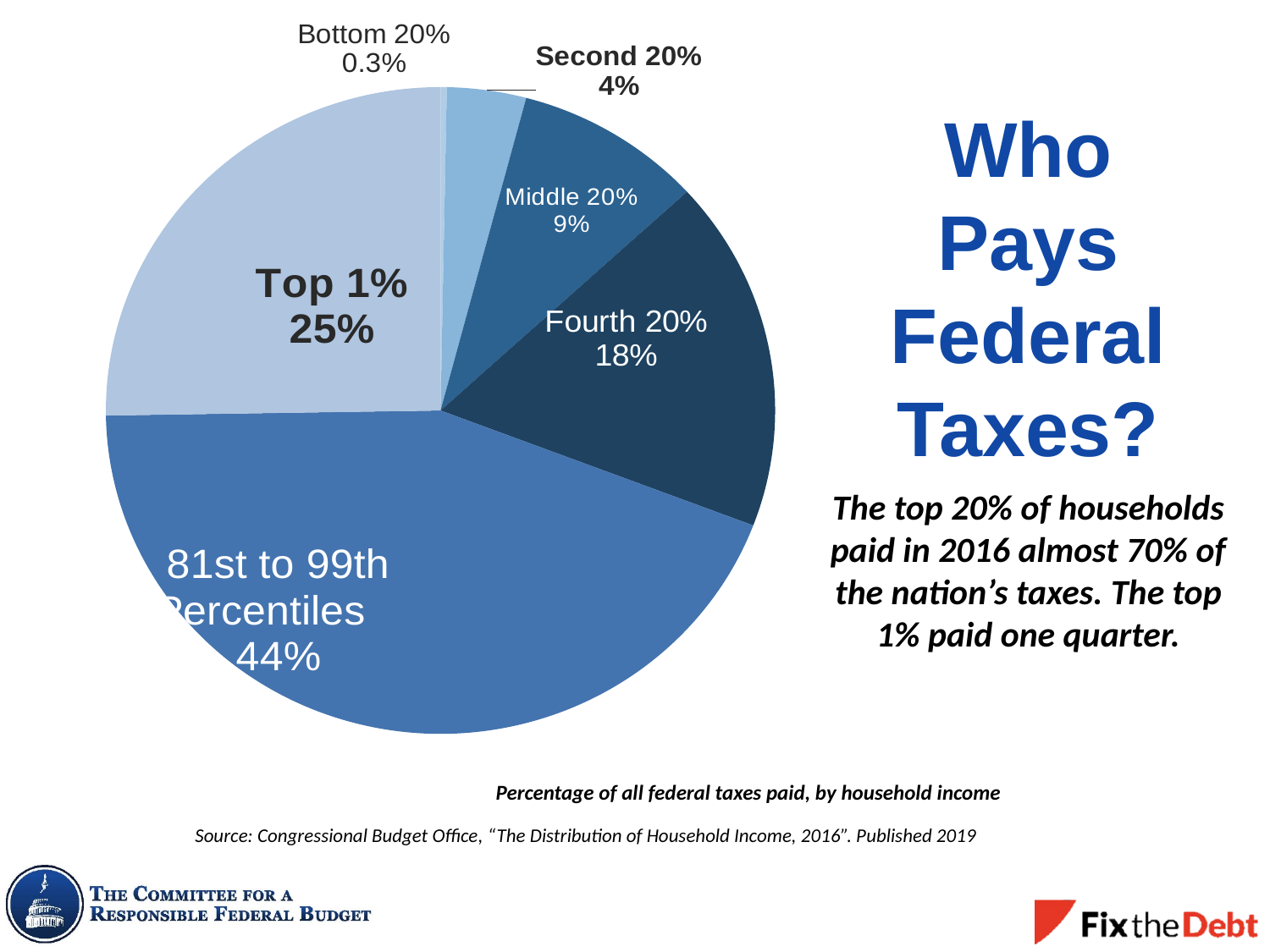
What is the title of the chart on the slide? Who Pays Federal Taxes? Which group pays the largest share of federal taxes? 81st to 99th Percentiles What is the combined share of federal taxes paid by the Second 20% and the Middle 20%? 13% What percentage of all federal taxes is paid by the Middle 20%? 9% What percentage of all federal taxes is paid by the Fourth 20%? 18% Which group pays the smallest share of federal taxes? Bottom 20% Which pays a larger share of federal taxes, the Fourth 20% or the Middle 20%? Fourth 20% What percentage of all federal taxes is paid by the Top 1%? 25% What kind of chart is shown on the slide? pie chart How many slices does the pie chart have? 6 What is the difference between the share paid by the 81st to 99th Percentiles and the share paid by the Top 1%? 19% What percentage of all federal taxes is paid by the Bottom 20%? 0.3%